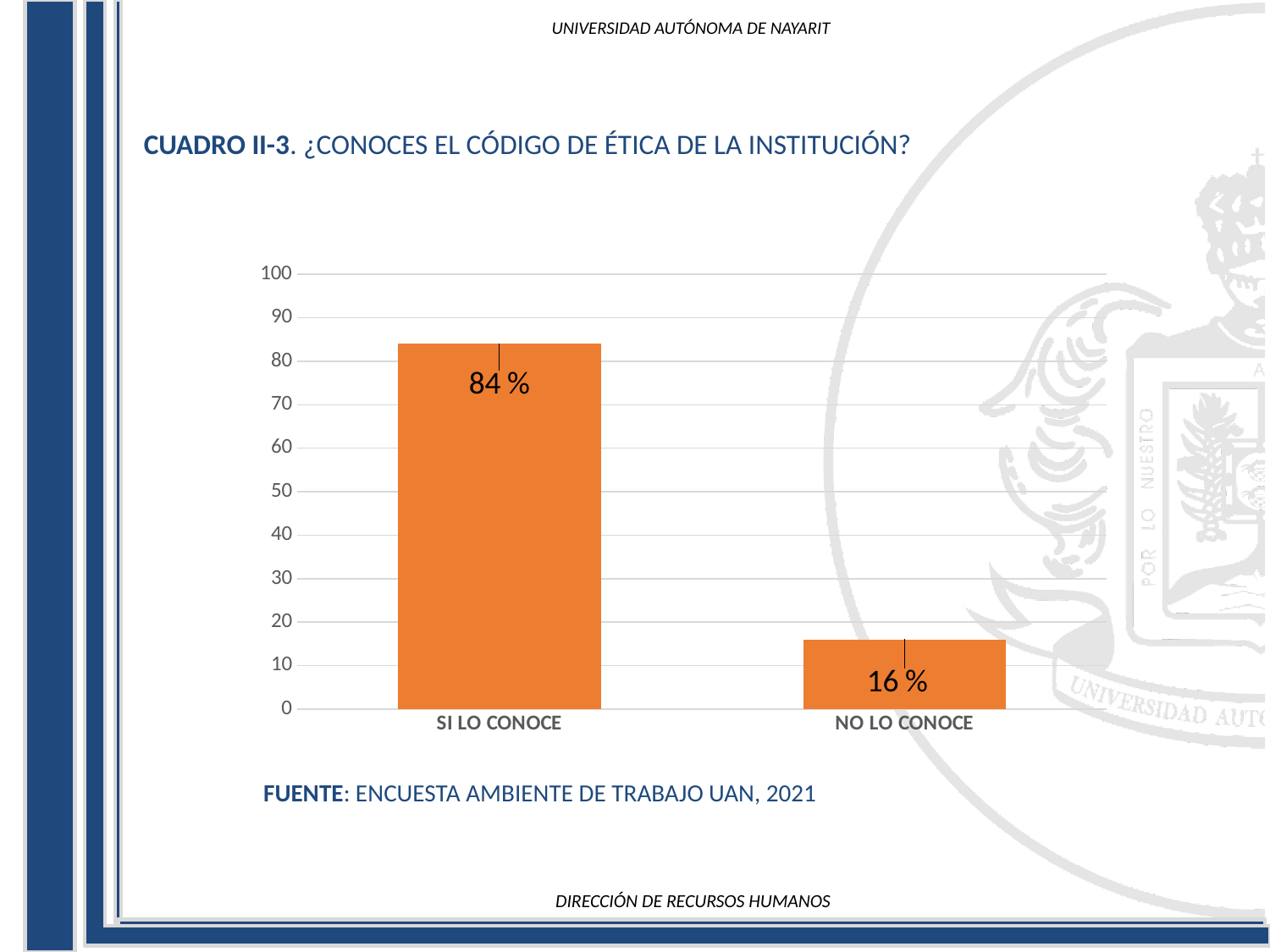
How many categories are shown on the x axis? 2 What is the value for NO LO CONOCE? 16 % Is the value for SI LO CONOCE greater or less than 80? greater What colour are the bars in the chart? orange Which category has the highest value? SI LO CONOCE What kind of chart is shown on the slide? bar chart Which is larger, the value for SI LO CONOCE or NO LO CONOCE? SI LO CONOCE Which category has the lowest value? NO LO CONOCE What is the value for SI LO CONOCE? 84 % What is the title of the chart on the slide? CUADRO II-3. ¿CONOCES EL CÓDIGO DE ÉTICA DE LA INSTITUCIÓN? What is the difference between the values for SI LO CONOCE and NO LO CONOCE? 68 % Is the value for NO LO CONOCE greater or less than 20? less